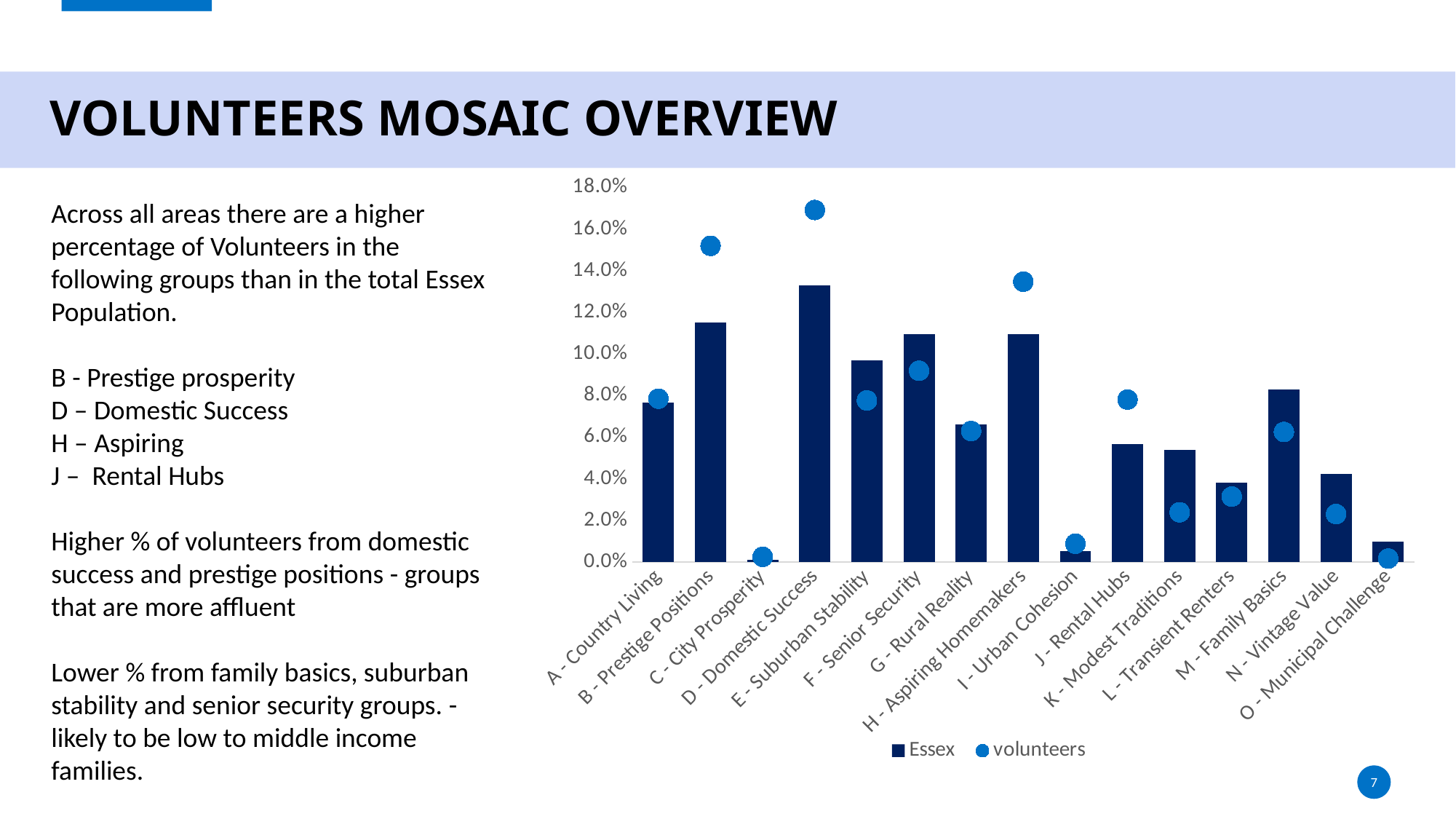
How many series does the chart legend list? 2 What kind of chart is used to plot the Essex series? Bar chart For E - Suburban Stability, which is larger: the Essex value or the volunteers value? Essex Which category has the highest Essex value? D - Domestic Success What are the two series named in the chart legend? Essex and volunteers Is the Essex value for K - Modest Traditions greater or less than 6.0%? less How many categories are shown along the x axis of the chart? 15 Which category has the highest volunteers value? D - Domestic Success Is the volunteers value for B - Prestige Positions greater or less than 14.0%? greater Which category has the lowest Essex value? C - City Prosperity For B - Prestige Positions, which is larger: the Essex value or the volunteers value? volunteers Is the Essex value for D - Domestic Success greater or less than 12.0%? greater